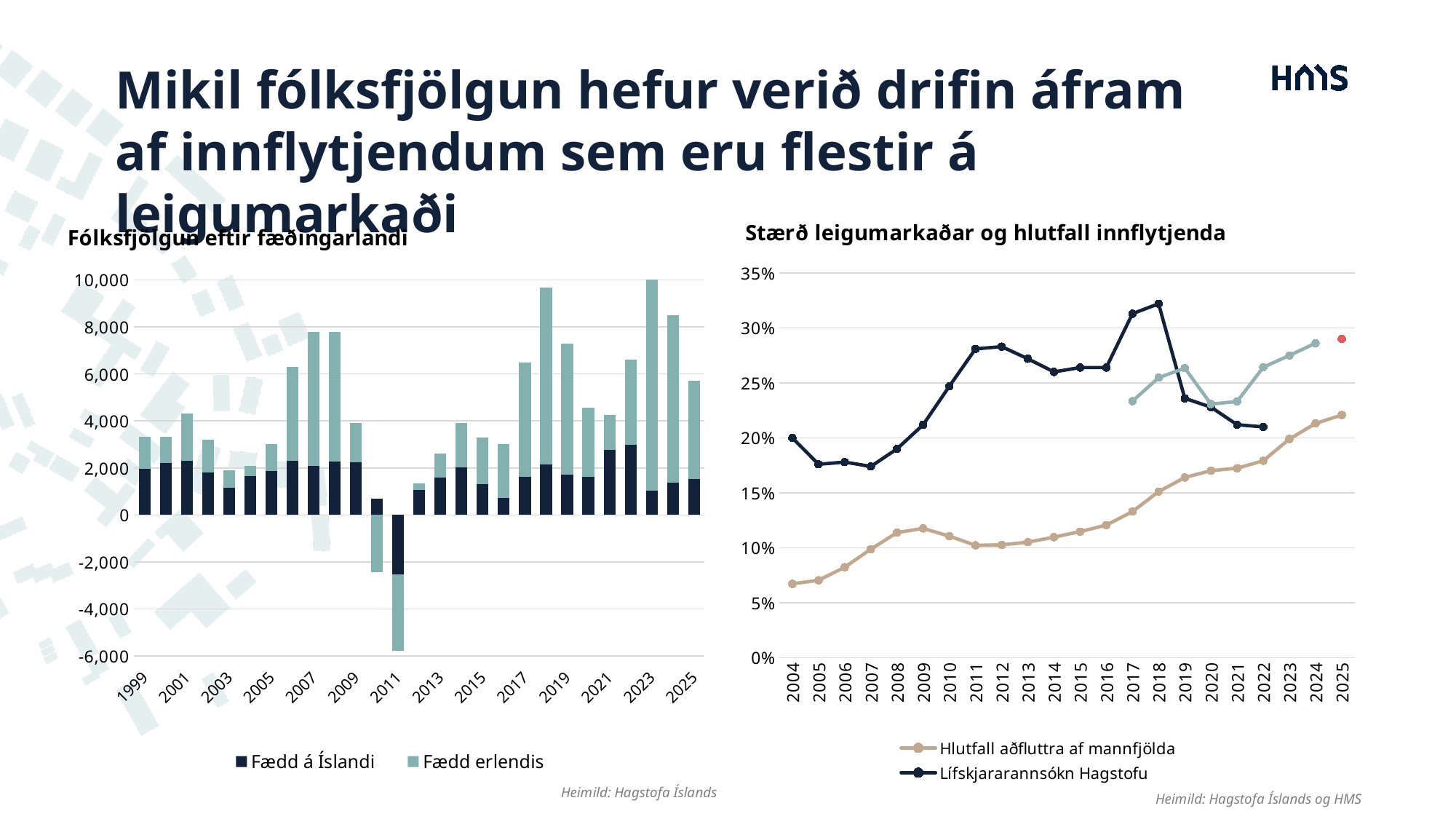
In the left chart 'Fólksfjölgun eftir fæðingarlandi', is the total for 2018 greater or less than 8,000? greater In the right chart 'Stærð leigumarkaðar og hlutfall innflytjenda', is the value of 'Lífskjararannsókn Hagstofu' in 2018 greater or less than 30%? greater In the right chart 'Stærð leigumarkaðar og hlutfall innflytjenda', does 'Hlutfall aðfluttra af mannfjölda' generally rise or fall from 2004 to 2024? rise In the left chart 'Fólksfjölgun eftir fæðingarlandi', which year has the larger total, 2023 or 2024? 2023 In the left chart 'Fólksfjölgun eftir fæðingarlandi', is the total for 2011 greater or less than -4,000? less How many series does the legend of the right chart 'Stærð leigumarkaðar og hlutfall innflytjenda' list? 2 What kind of chart is the left chart, 'Fólksfjölgun eftir fæðingarlandi'? Bar chart How many series does the legend of the left chart 'Fólksfjölgun eftir fæðingarlandi' list? 2 What are the two legend entries of the left chart 'Fólksfjölgun eftir fæðingarlandi'? Fædd á Íslandi and Fædd erlendis What kind of chart is the right chart, 'Stærð leigumarkaðar og hlutfall innflytjenda'? Line chart In the left chart 'Fólksfjölgun eftir fæðingarlandi', which year has the lowest total? 2011